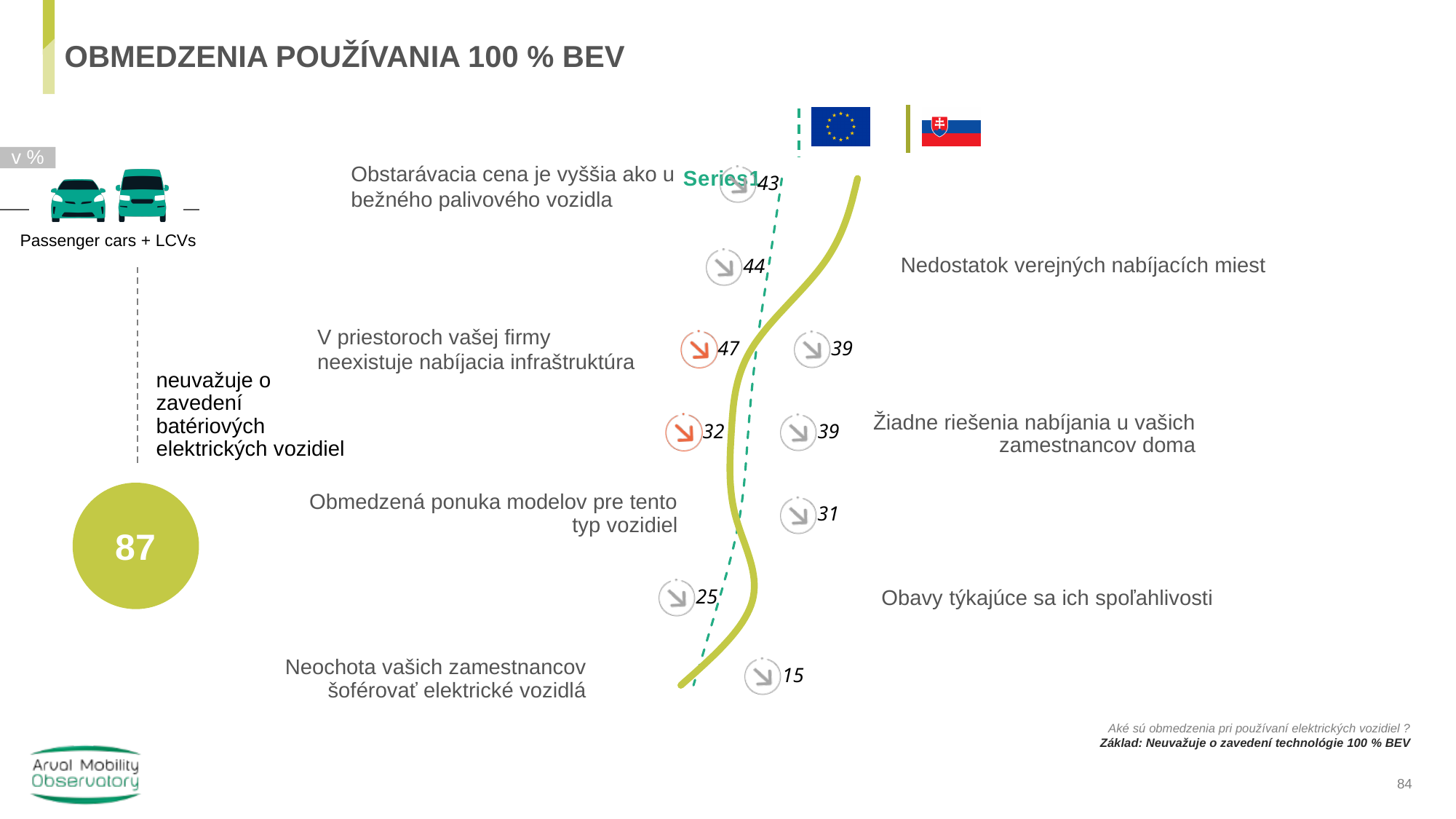
Which limitation has the lowest printed value? Neochota vašich zamestnancov šoférovať elektrické vozidlá Which is larger: the value for "Nedostatok verejných nabíjacích miest" or the value for "Obmedzená ponuka modelov pre tento typ vozidiel"? Nedostatok verejných nabíjacích miest How many limitation categories are listed on the chart? 7 Do the printed values generally rise or fall going from the top category to the bottom category? fall What value is printed for "Obstarávacia cena je vyššia ako u bežného palivového vozidla"? 43 What is the highest value printed on the chart? 47 What value is printed for "Neochota vašich zamestnancov šoférovať elektrické vozidlá"? 15 What is the difference between the values for "Obavy týkajúce sa ich spoľahlivosti" and "Neochota vašich zamestnancov šoférovať elektrické vozidlá"? 10 What value is printed for "Obavy týkajúce sa ich spoľahlivosti"? 25 What value is printed for "Obmedzená ponuka modelov pre tento typ vozidiel"? 31 What value is printed for "Nedostatok verejných nabíjacích miest"? 44 What kind of chart is shown on the slide? line chart